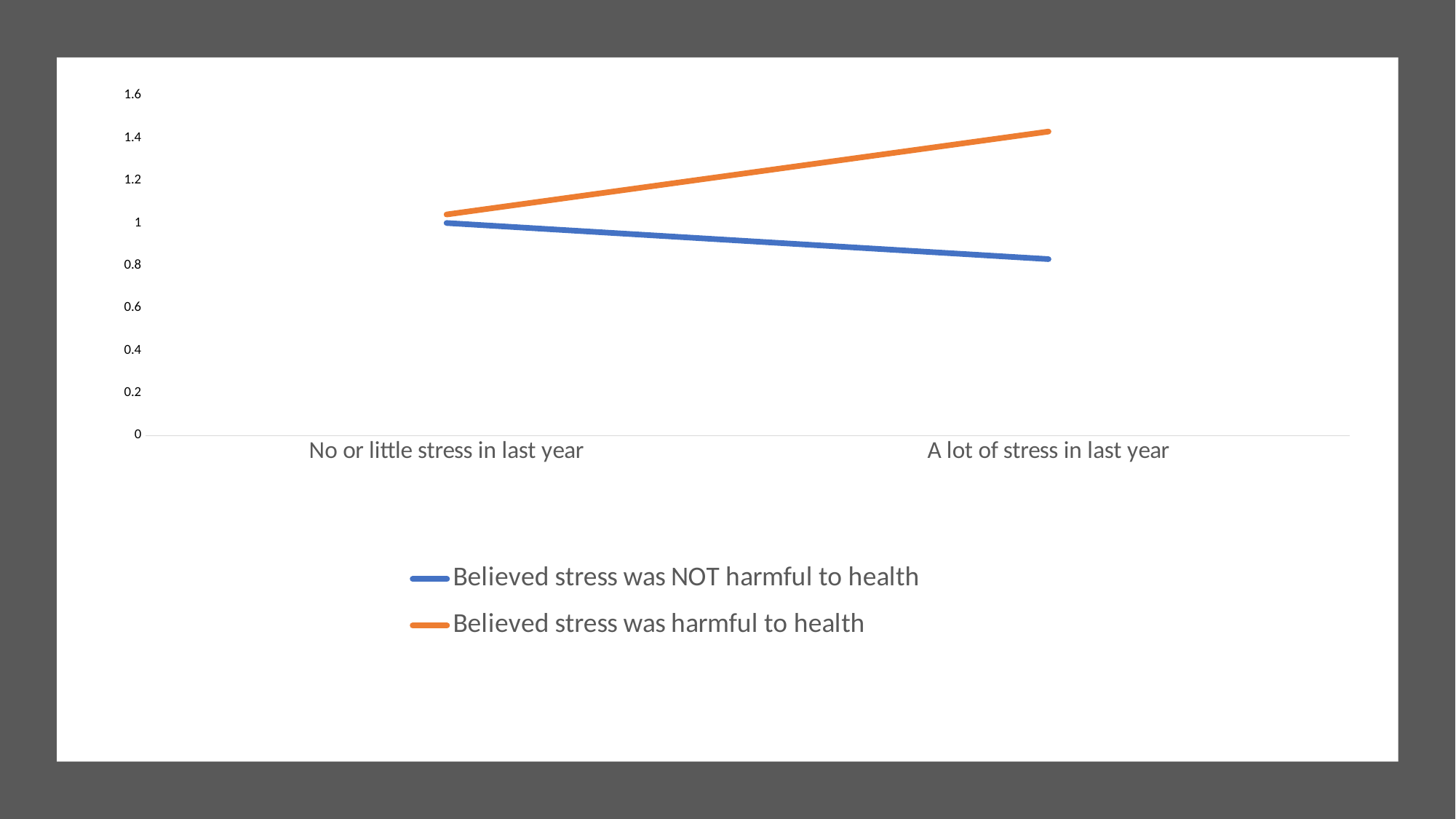
Does the line for "Believed stress was NOT harmful to health" rise or fall from "No or little stress in last year" to "A lot of stress in last year"? fall At "A lot of stress in last year", which series has the higher value? Believed stress was harmful to health Does the line for "Believed stress was harmful to health" rise or fall from "No or little stress in last year" to "A lot of stress in last year"? rise How many categories are shown on the x axis? 2 Which series reaches the highest value on the chart? Believed stress was harmful to health What kind of chart is shown on the slide? line chart Is the value for "Believed stress was harmful to health" at "A lot of stress in last year" greater or less than 1.2? greater How many series does the legend list? 2 Is the value for "Believed stress was NOT harmful to health" at "A lot of stress in last year" greater or less than 1? less Is the value for "Believed stress was harmful to health" at "No or little stress in last year" greater or less than 0.8? greater What is the value for "Believed stress was NOT harmful to health" at "No or little stress in last year"? 1 What colour is the line for "Believed stress was harmful to health"? orange